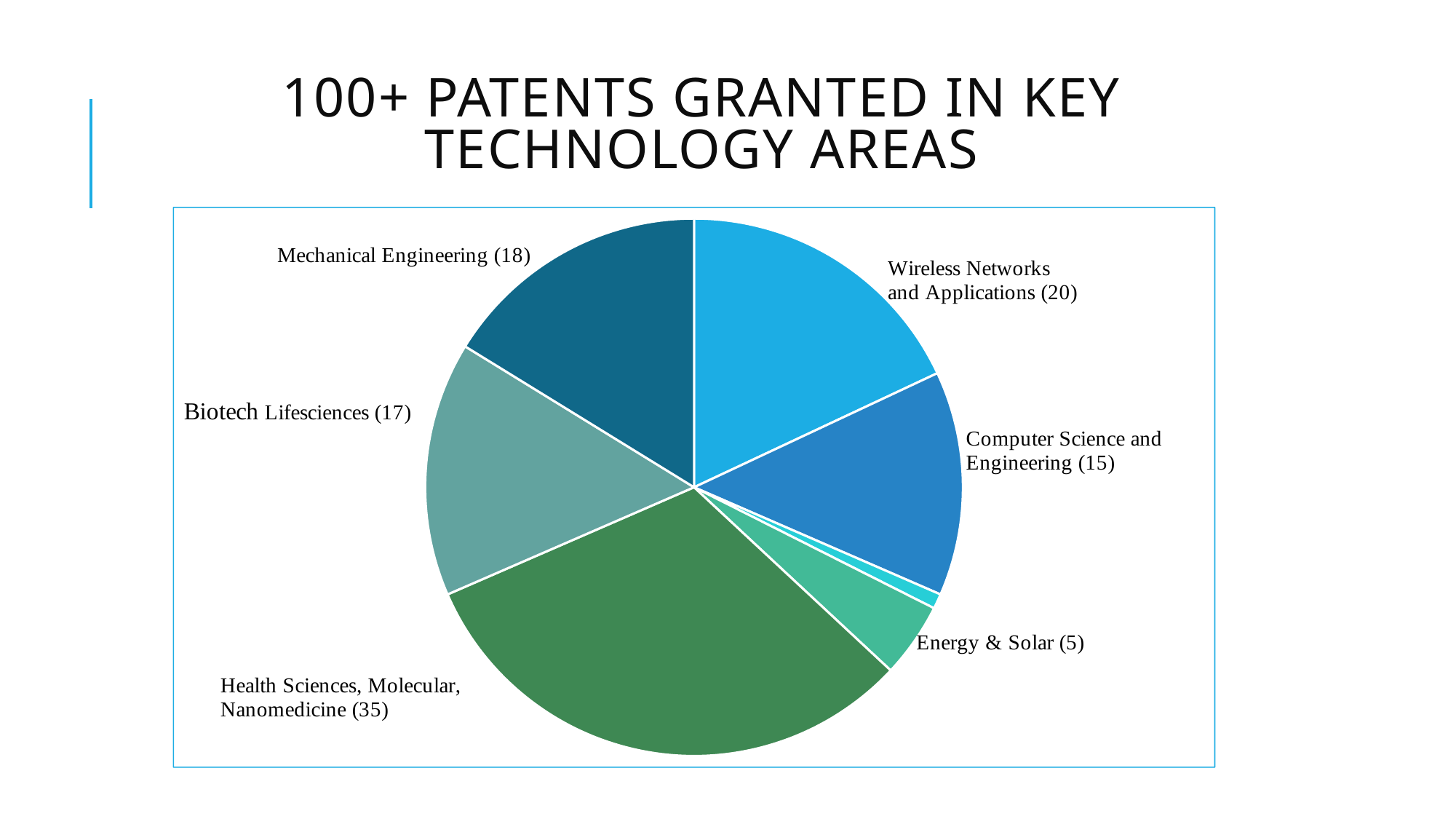
Which has more patents, Mechanical Engineering or Computer Science and Engineering? Mechanical Engineering How many patents were granted in Health Sciences, Molecular, Nanomedicine? 35 How many patents were granted in Wireless Networks and Applications? 20 How many patents were granted in Energy & Solar? 5 What is the difference in patents between Health Sciences, Molecular, Nanomedicine and Wireless Networks and Applications? 15 Which labeled technology area has the largest number of patents? Health Sciences, Molecular, Nanomedicine How many patents were granted in Biotech Lifesciences? 17 How many patents were granted in Computer Science and Engineering? 15 What is the title of the slide? 100+ Patents Granted in Key Technology Areas What type of chart is shown on the slide? pie chart How many patents were granted in Mechanical Engineering? 18 What is the difference in patents between Mechanical Engineering and Biotech Lifesciences? 1